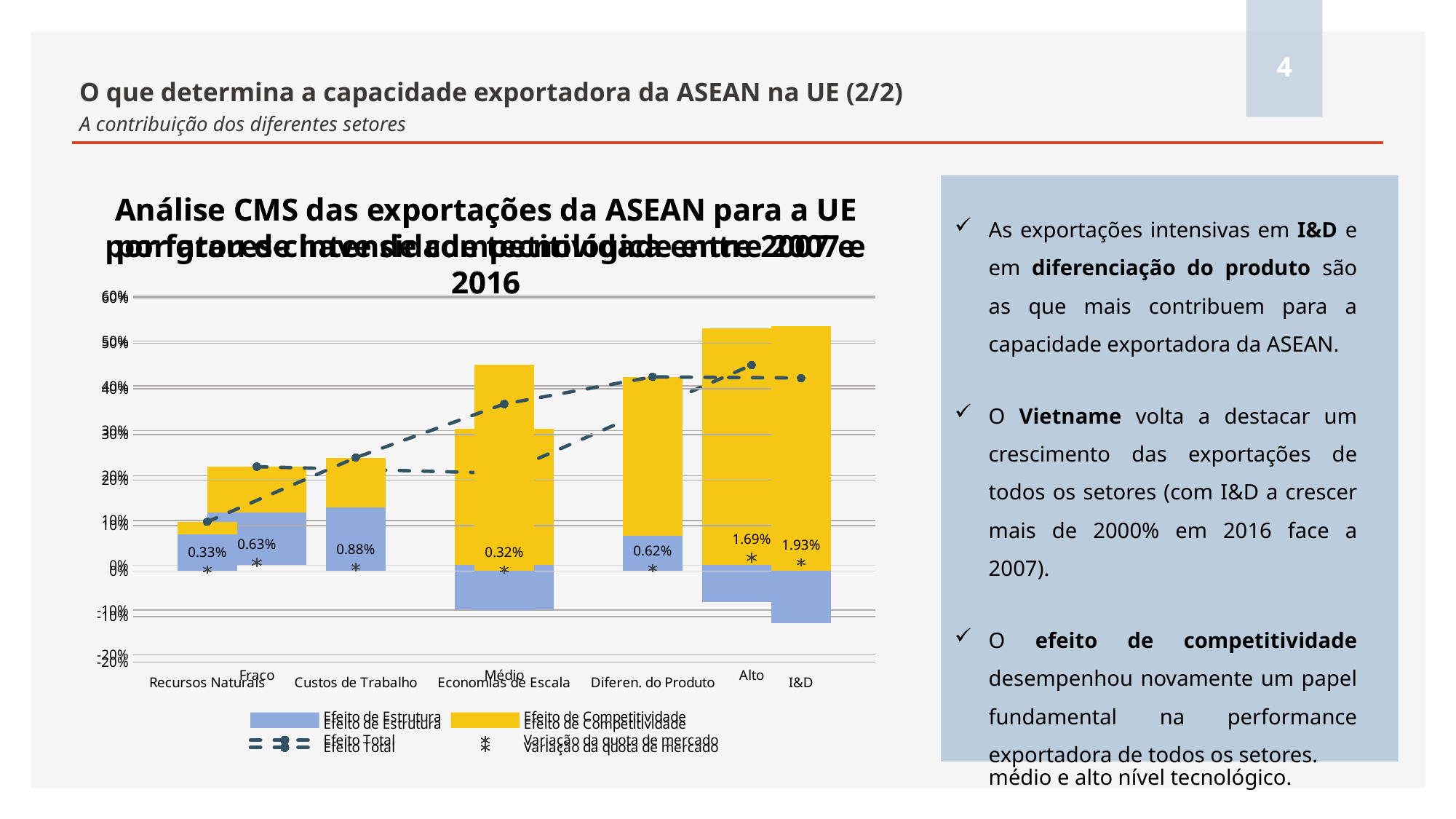
Which legend entry is represented by the yellow bars? Efeito de Competitividade How many series does the legend list? 4 What is the Variação da quota de mercado value shown for Recursos Naturais? 0.33% What is the difference between the Variação da quota de mercado values for I&D and Recursos Naturais? 1.60% What is the Variação da quota de mercado value shown for Custos de Trabalho? 0.88% Which has the larger Variação da quota de mercado value, Alto or I&D? I&D What kind of chart is used to show the Efeito de Estrutura and Efeito de Competitividade series? Bar chart What is the Variação da quota de mercado value shown for I&D? 1.93% What is the Variação da quota de mercado value shown for Diferen. do Produto? 0.62% Which category has the highest labelled Variação da quota de mercado value? I&D Is the Efeito de Competitividade bar for I&D greater or less than 50%? greater What is the Variação da quota de mercado value shown for Alto? 1.69%